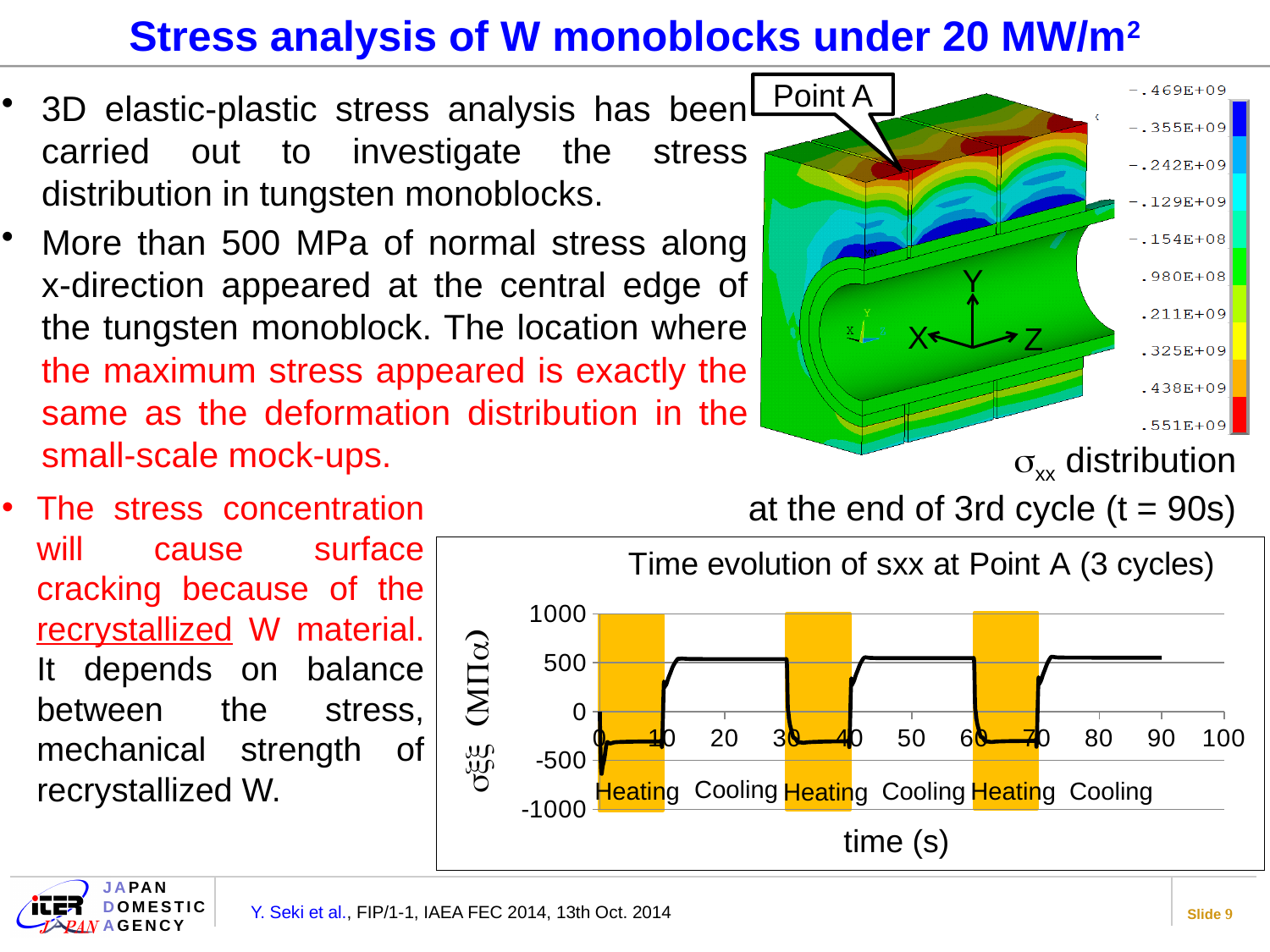
What is the x-axis label of the chart at the bottom of the slide? time (s) In the chart at the bottom of the slide, is the value at time 85 s greater or less than 1000? less In the chart at the bottom of the slide, does the value rise or fall when moving from time 5 s to time 20 s? rise What is the largest tick value shown on the x axis of the chart at the bottom of the slide? 100 In the chart at the bottom of the slide, is the value at time 65 s greater or less than 0? less In the chart at the bottom of the slide, is the value at time 5 s greater or less than 0? less How many heating phases are shaded in the chart at the bottom of the slide? 3 What kind of chart is shown at the bottom of the slide? line chart What is the title of the chart at the bottom of the slide? Time evolution of sxx at Point A (3 cycles)